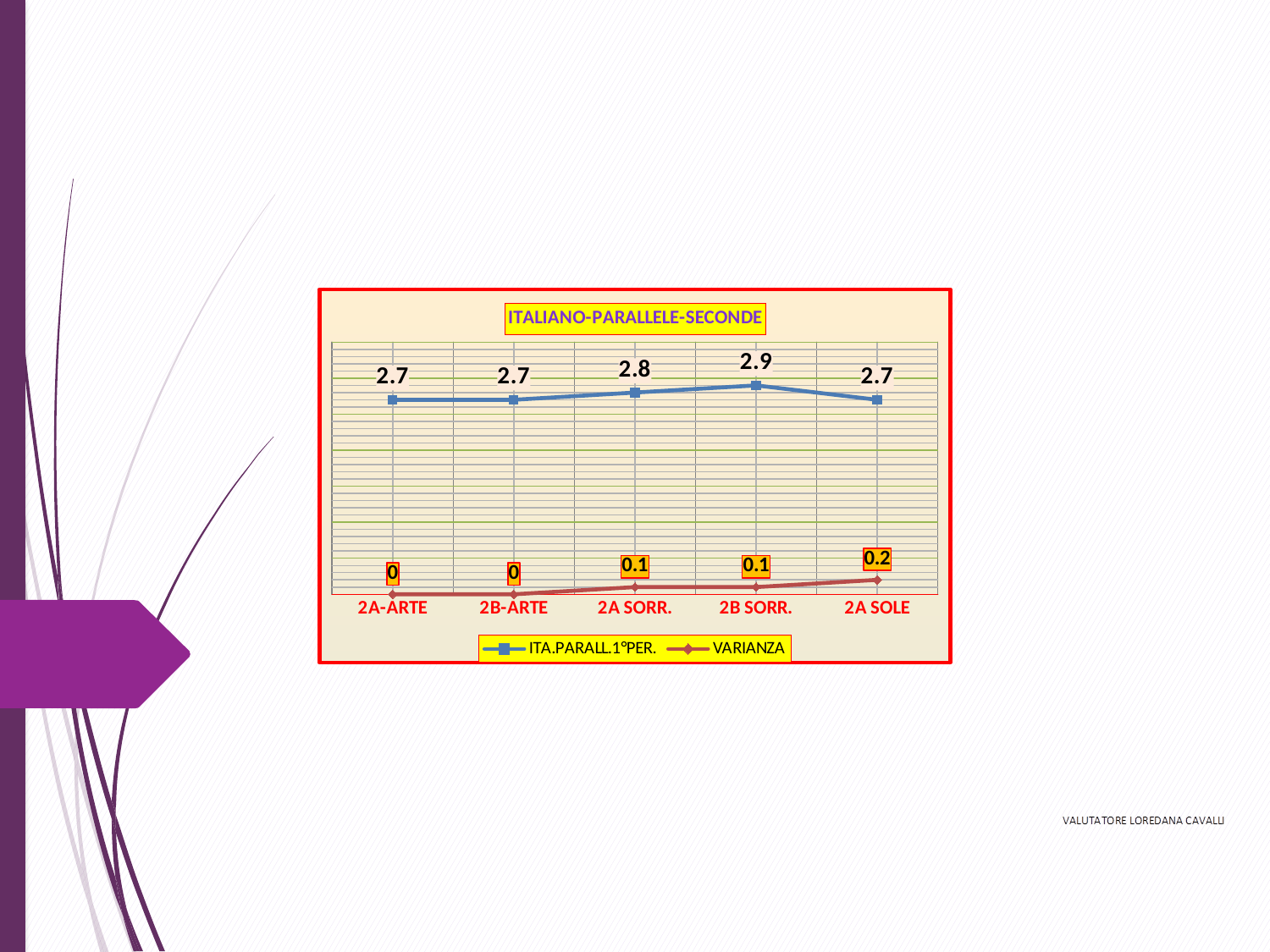
Which category has the highest ITA.PARALL.1°PER. value? 2B SORR. Which is larger, the ITA.PARALL.1°PER. value for 2A SORR. or for 2A-ARTE? 2A SORR. Which category has the highest VARIANZA value? 2A SOLE What is the VARIANZA value for 2A SOLE? 0.2 What is the ITA.PARALL.1°PER. value for 2B SORR.? 2.9 How many categories are shown on the x axis? 5 What is the VARIANZA value for 2B-ARTE? 0 How many series does the legend list? 2 What is the title of the chart? ITALIANO-PARALLELE-SECONDE What is the difference between the ITA.PARALL.1°PER. values for 2B SORR. and 2A SOLE? 0.2 What kind of chart is shown on the slide? line chart What is the ITA.PARALL.1°PER. value for 2A SORR.? 2.8